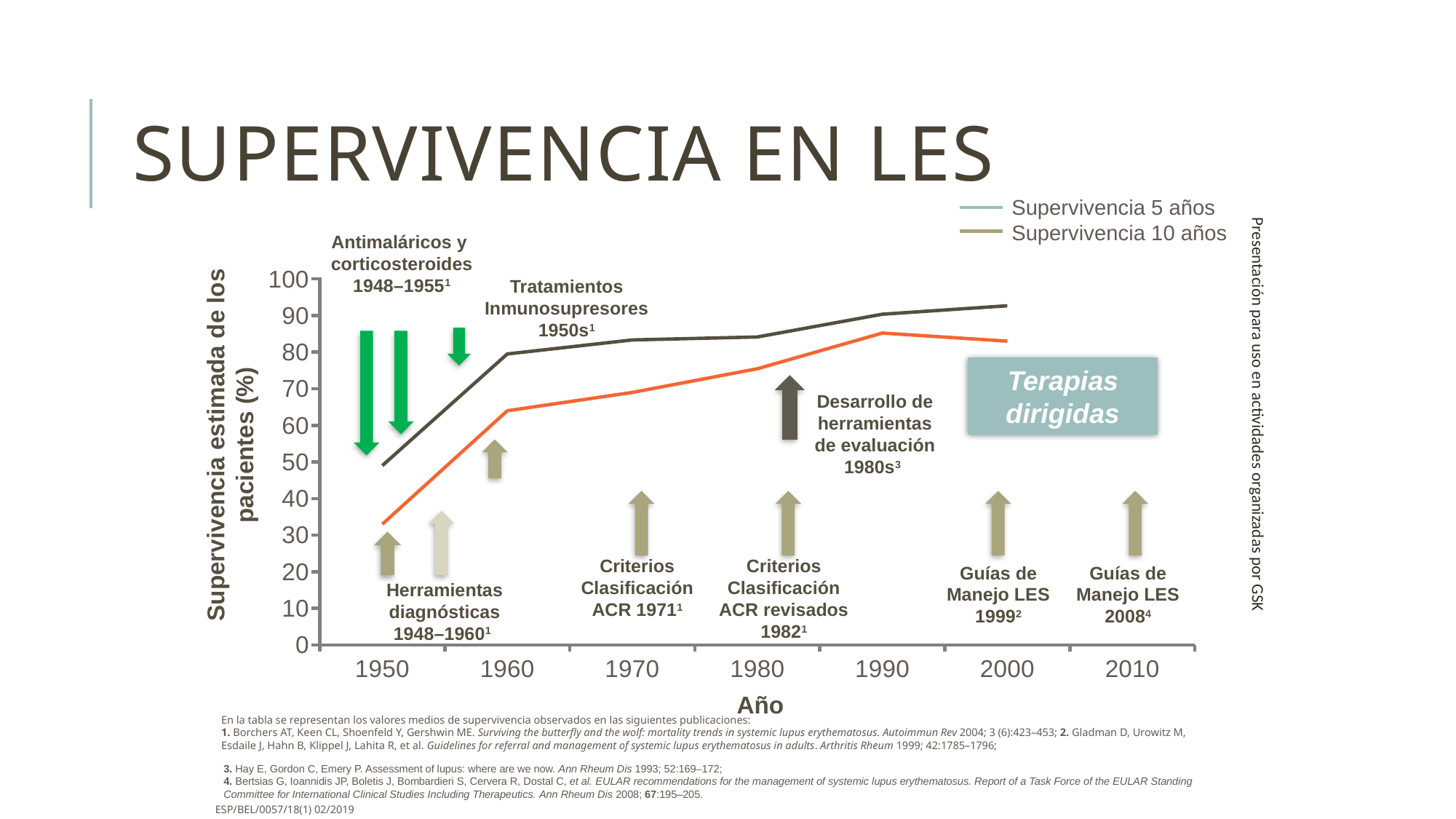
What are the two series named in the legend? Supervivencia 5 años and Supervivencia 10 años Is the value of the orange line at 1950 greater or less than 40? less Does the orange line rise or fall between 1990 and 2000? fall Is the value of the orange line at 1960 greater or less than 60? greater How many year ticks are labelled on the x axis? 7 Is the value of the dark upper line at 1970 greater or less than 80? greater What is the label of the x axis? Año Does the dark upper line rise or fall between 1950 and 1990? rise What kind of chart is shown on the slide? line chart At 1960, which line has the higher value, the dark upper line or the orange line? the dark upper line How many series does the legend list? 2